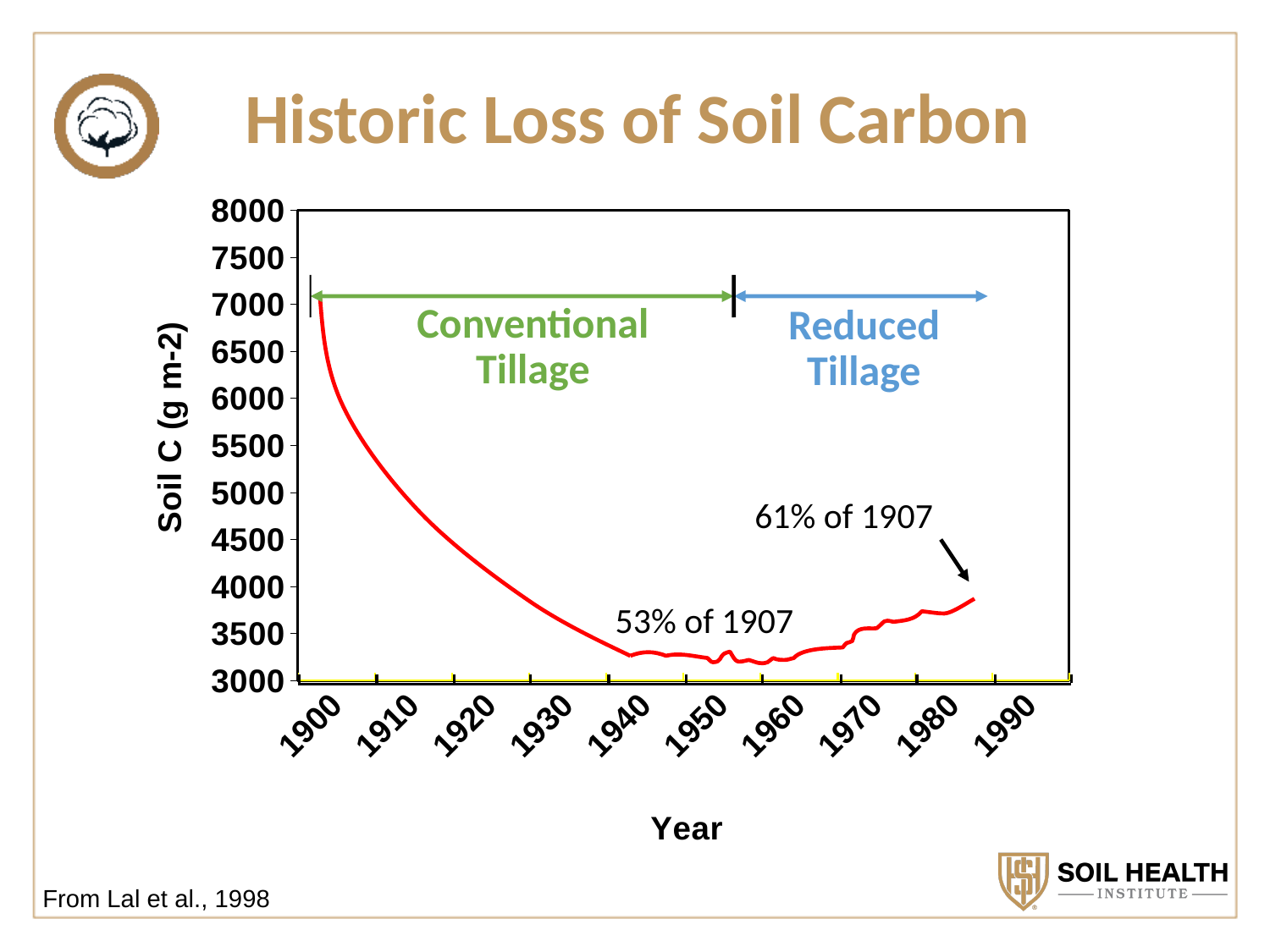
Is the soil carbon value in 1900 greater or less than 6500? greater What is the label of the y axis of the chart? Soil C (g m-2) What is the title of the chart on the slide? Historic Loss of Soil Carbon Does the soil carbon value rise or fall between 1960 and 1985? rise Which year has the higher soil carbon value, 1950 or 1980? 1980 Does the soil carbon value rise or fall between 1900 and 1940? fall Is the soil carbon value in 1920 greater or less than 5000? less What kind of chart is shown on the slide? line chart Which year has the higher soil carbon value, 1900 or 1980? 1900 Is the soil carbon value in 1910 greater or less than 5000? greater According to the annotation, the lowest point of the curve is what percentage of the 1907 value? 53%